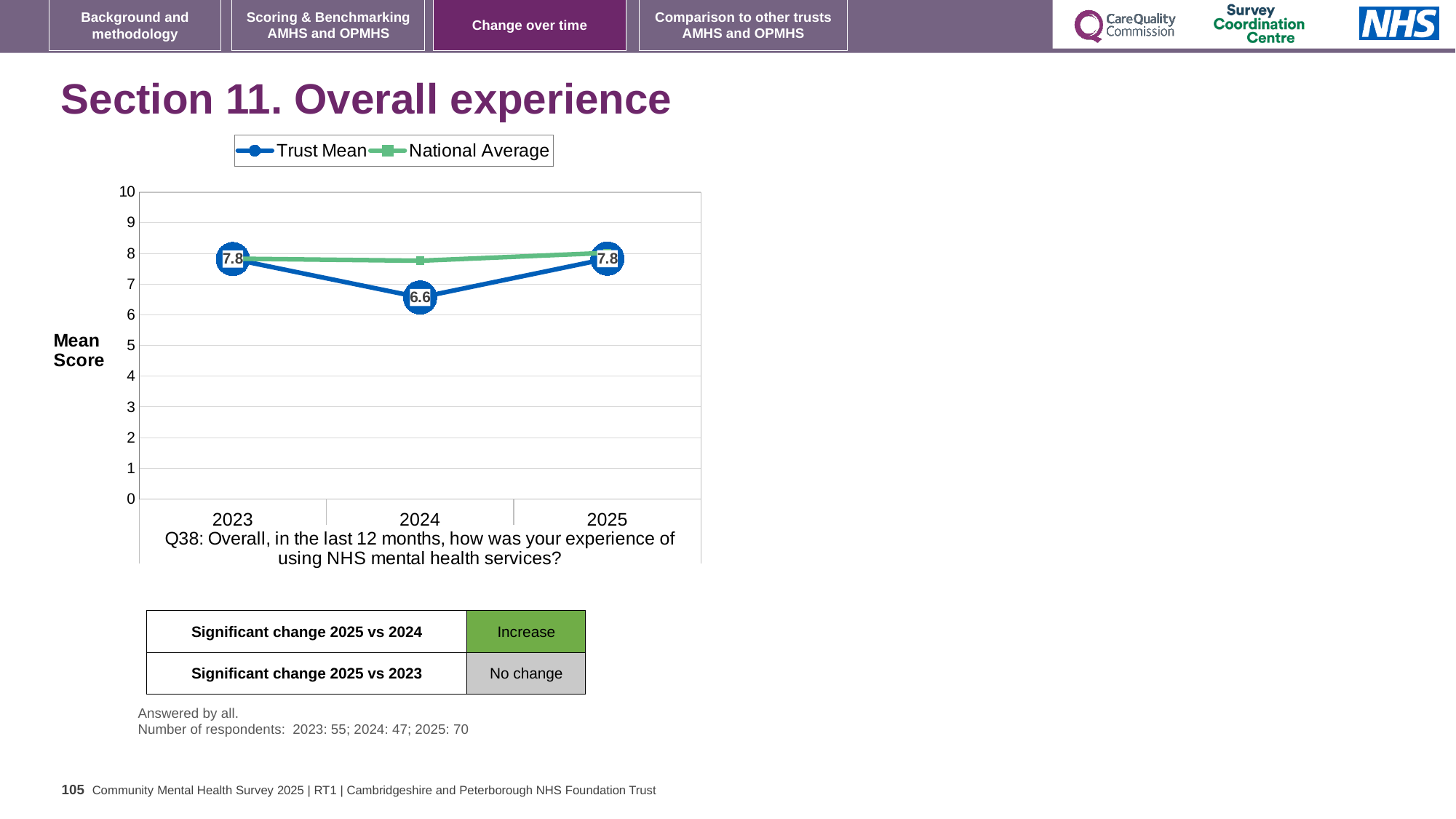
What is the Trust Mean score for 2025? 7.8 How many series does the legend list? 2 What is the difference between the Trust Mean in 2023 and in 2024? 1.2 What kind of chart is shown on the slide? line chart Does the Trust Mean rise or fall from 2023 to 2024? fall What is the Trust Mean score for 2024? 6.6 Is the National Average value for 2024 greater or less than 7? greater Which is larger, the Trust Mean in 2024 or the Trust Mean in 2025? 2025 What is the Trust Mean score for 2023? 7.8 In which year is the Trust Mean lowest? 2024 Is the Trust Mean value for 2024 greater or less than 7? less How many years are plotted on the x axis? 3